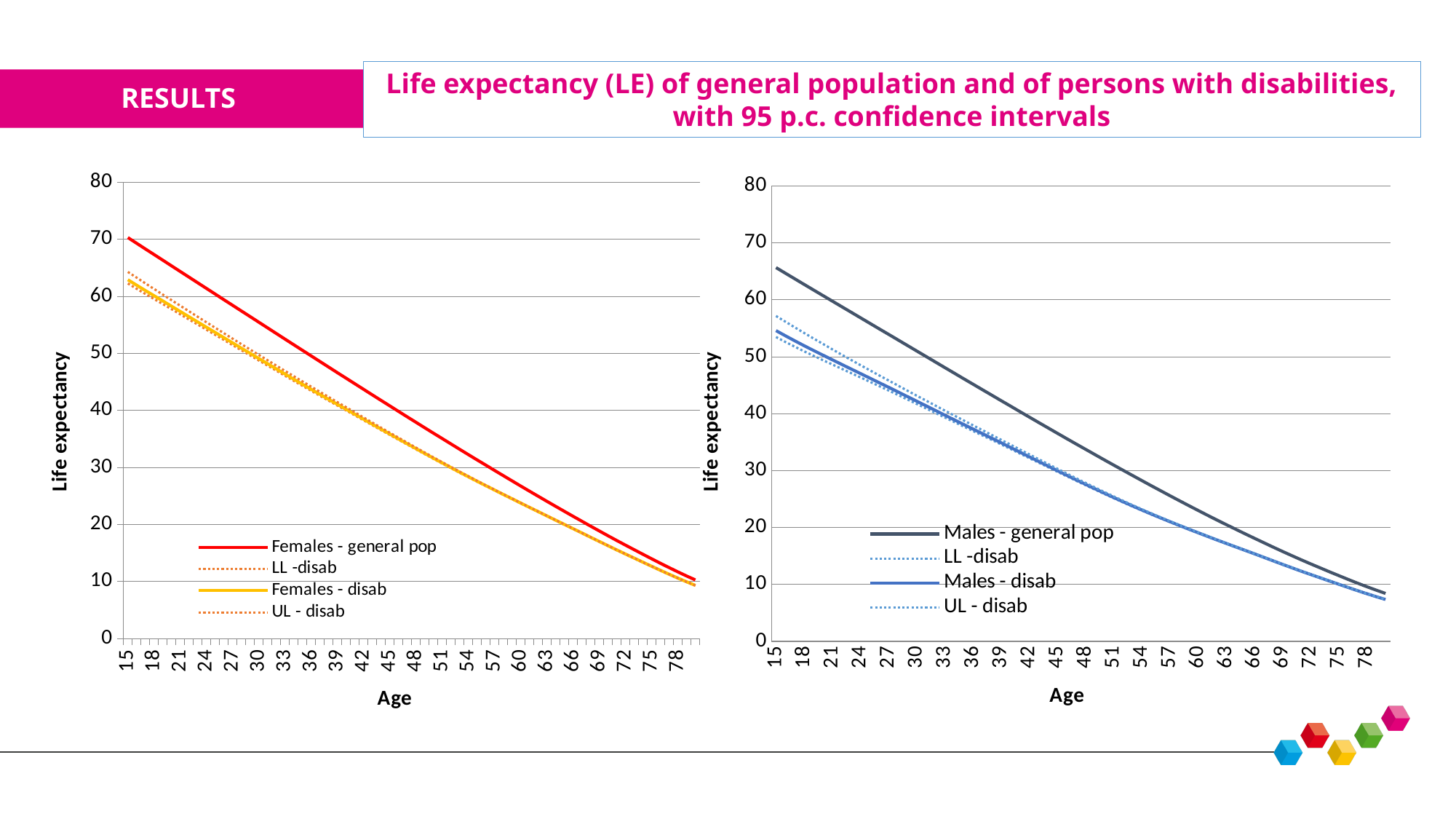
In the right chart (Males), is the value for Males - disab at age 15 greater or less than 50? greater How many series does the legend of the right chart (Males) list? 4 At age 15, which is larger: Females - general pop in the left chart or Males - general pop in the right chart? Females - general pop What kind of chart is the left chart (Females)? line chart In the left chart (Females), does the Females - general pop line rise or fall as age increases? fall What is the x-axis title of the left chart (Females)? Age In the left chart (Females), is the value for Females - disab at age 15 greater or less than 60? greater In the right chart (Males), does the Males - disab line rise or fall as age increases? fall How many series does the legend of the left chart (Females) list? 4 In the left chart (Females), which is larger at age 15: Females - general pop or Females - disab? Females - general pop What is the y-axis title of the right chart (Males)? Life expectancy In the right chart (Males), is the value for Males - general pop at age 15 greater or less than 60? greater